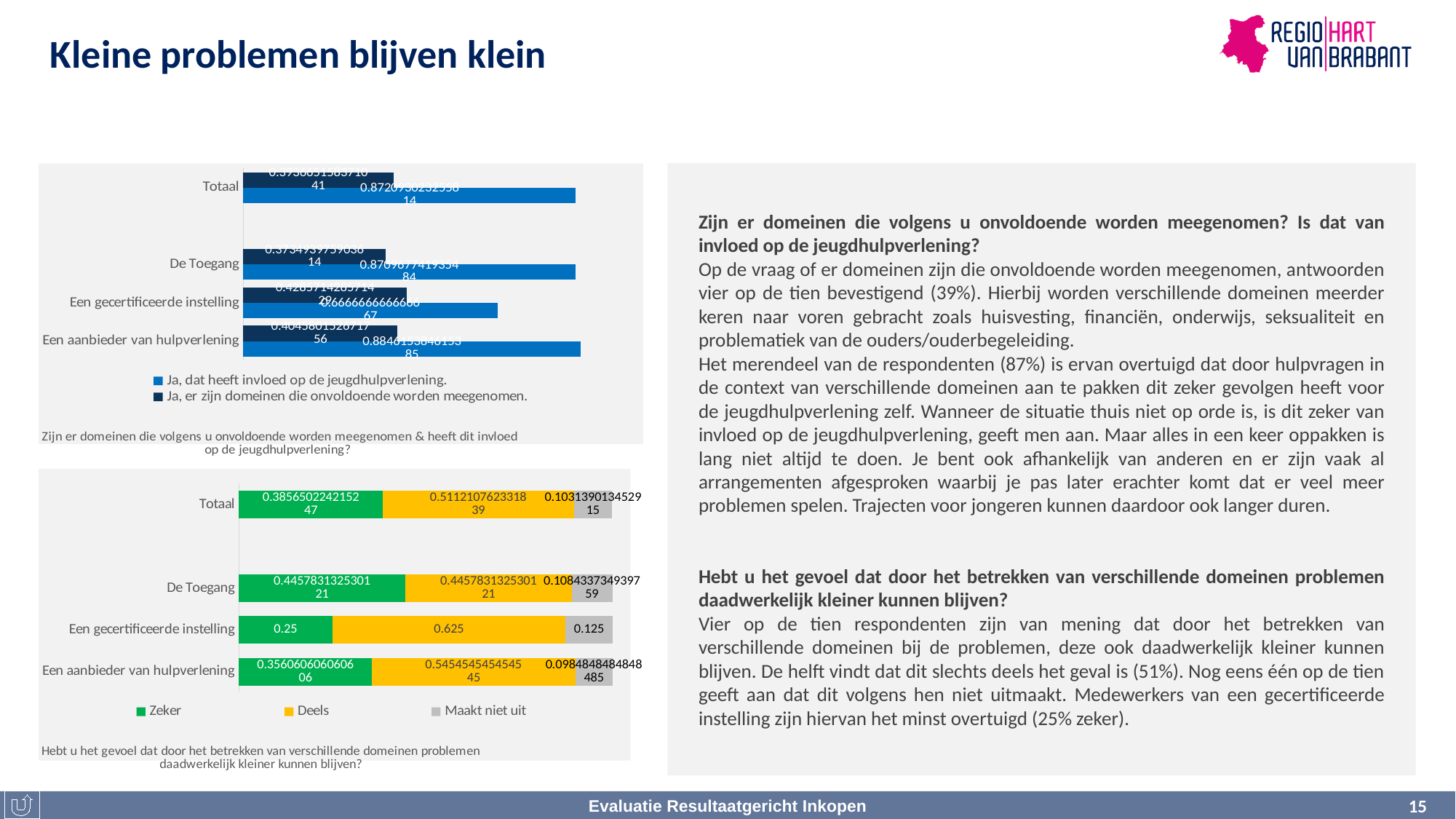
In the bottom chart, what is the total of the stacked bar for Een gecertificeerde instelling? 1 In the bottom chart, which category has the highest Zeker value? De Toegang In the bottom chart, what is the Maakt niet uit value for Een gecertificeerde instelling? 0.125 In the bottom chart (Hebt u het gevoel dat door het betrekken van verschillende domeinen problemen daadwerkelijk kleiner kunnen blijven?), what is the Zeker value for Een gecertificeerde instelling? 0.25 In the bottom chart, what is the Deels value for Een gecertificeerde instelling? 0.625 How many series does the legend of the bottom chart list? 3 In the bottom chart, which category has the highest Deels value? Een gecertificeerde instelling In the top chart, for Totaal, which series has the larger value: 'Ja, dat heeft invloed op de jeugdhulpverlening.' or 'Ja, er zijn domeinen die onvoldoende worden meegenomen.'? Ja, dat heeft invloed op de jeugdhulpverlening. In the top chart (Zijn er domeinen die volgens u onvoldoende worden meegenomen & heeft dit invloed op de jeugdhulpverlening?), which category has the lowest value for 'Ja, dat heeft invloed op de jeugdhulpverlening.'? Een gecertificeerde instelling How many categories are shown in the top chart? 4 In the bottom chart, what is the difference between the Deels and Zeker values for Een gecertificeerde instelling? 0.375 In the bottom chart, which category has the lowest Zeker value? Een gecertificeerde instelling